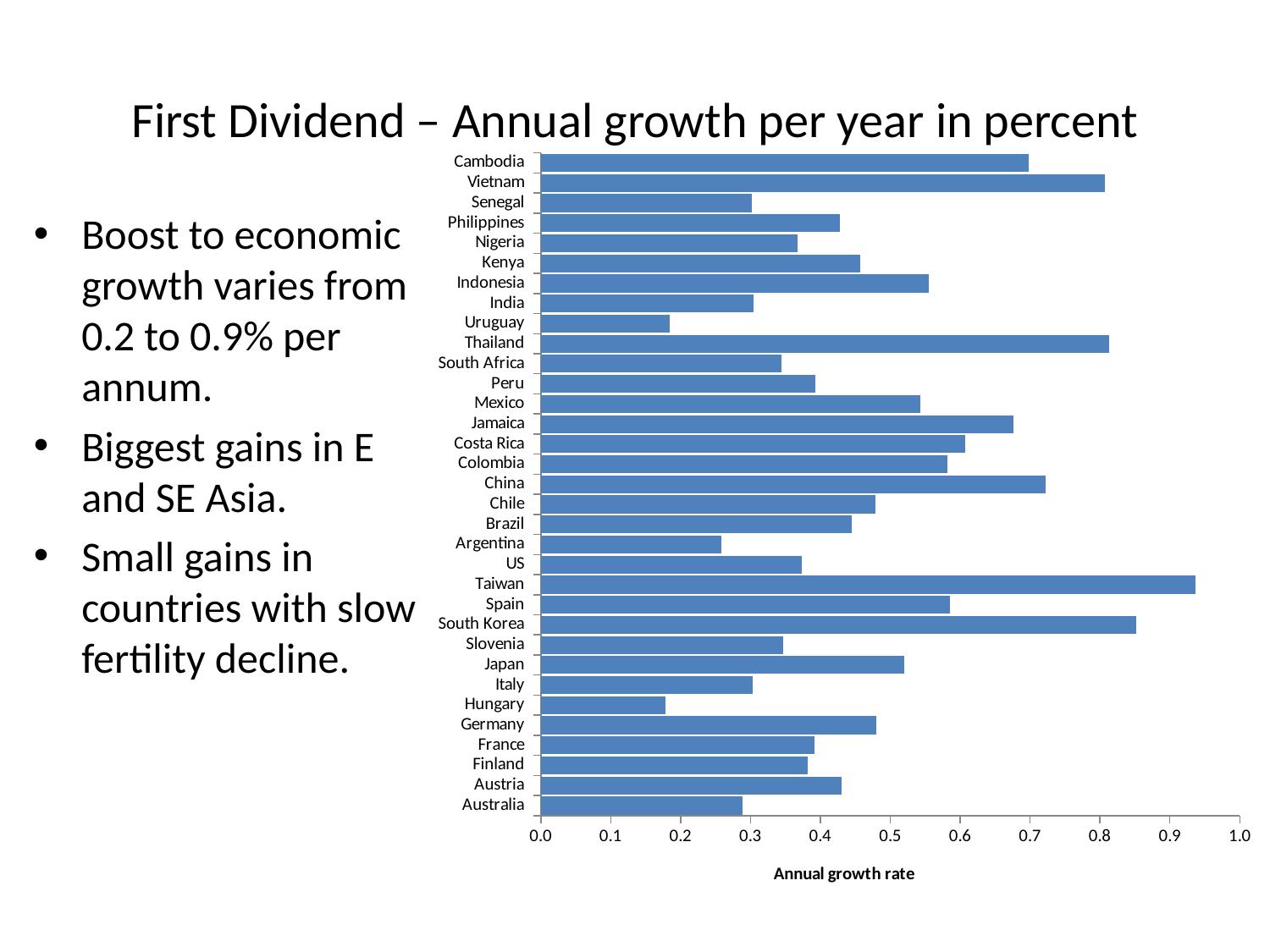
Is the value for Argentina greater or less than 0.3? less What is the title of the slide containing the chart? First Dividend – Annual growth per year in percent What kind of chart is shown on the slide? bar chart Which has the larger annual growth rate, Taiwan or South Korea? Taiwan Which has the larger annual growth rate, Japan or Italy? Japan Is the value for South Korea greater or less than 0.8? greater Is the value for Vietnam greater or less than 0.7? greater Which country has the highest annual growth rate in the chart? Taiwan What is the label on the horizontal axis of the chart? Annual growth rate How many countries are plotted in the chart? 33